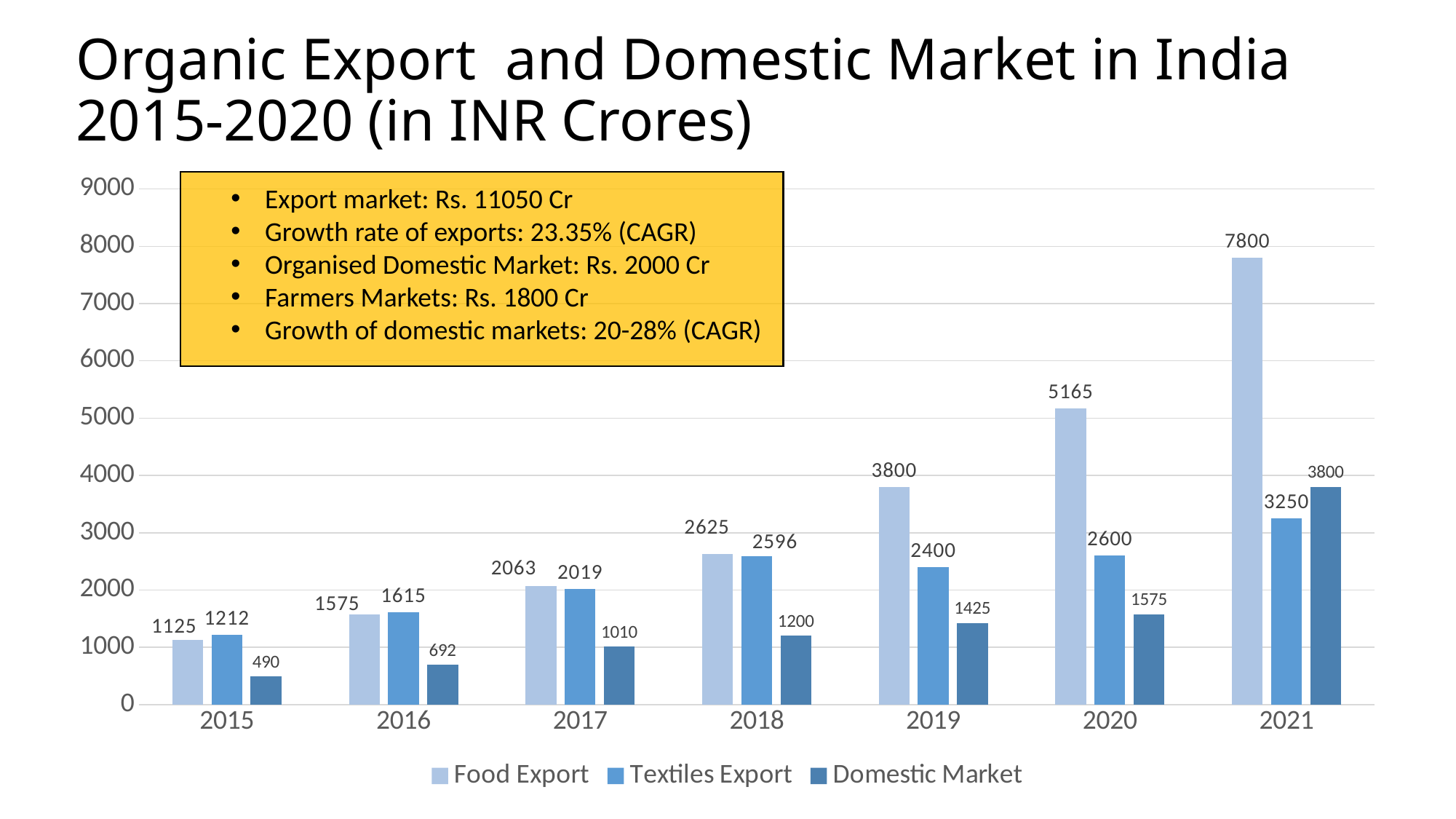
What is the difference between the Food Export values for 2021 and 2020? 2635 Which year has the lowest Domestic Market value? 2015 What kind of chart is shown on the slide? Bar chart Do the Domestic Market values rise or fall from 2015 to 2021? Rise What is the Textiles Export value for 2018? 2596 What is the Domestic Market value for 2015? 490 How many years are shown on the x axis? 7 How many series does the legend list? 3 Is the Food Export value for 2020 greater or less than 5000? greater What is the Food Export value for 2021? 7800 Which year has the highest Food Export value? 2021 Which is larger in 2016, Food Export or Textiles Export? Textiles Export